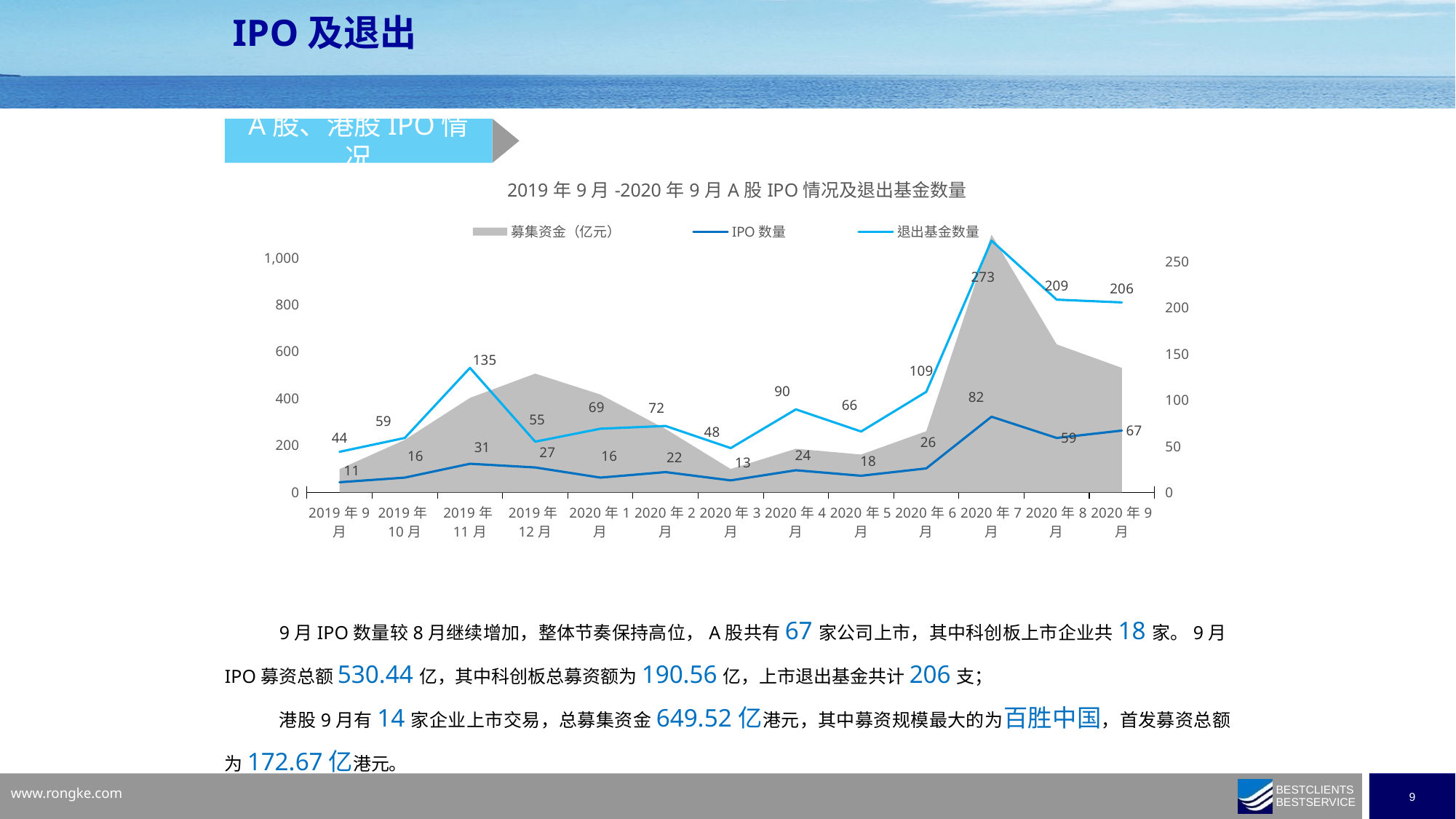
What is the title of the chart? 2019 年 9 月 -2020 年 9 月 A 股 IPO 情况及退出基金数量 What is the difference between IPO 数量 in 2020 年 7 月 and 2020 年 6 月? 56 What is the difference between 退出基金数量 in 2020 年 8 月 and 2020 年 9 月? 3 What is the IPO 数量 value for 2020 年 7 月? 82 In which month is IPO 数量 the lowest? 2019 年 9 月 How many series does the chart legend list? 3 How many months are shown on the x axis of the chart? 13 Which month has the larger IPO 数量, 2020 年 8 月 or 2020 年 9 月? 2020 年 9 月 Does IPO 数量 rise or fall from 2020 年 5 月 to 2020 年 7 月? rise What is the 退出基金数量 value for 2019 年 11 月? 135 Is the 募集资金（亿元） value for 2020 年 7 月 greater or less than 800? greater In which month is 退出基金数量 the highest? 2020 年 7 月